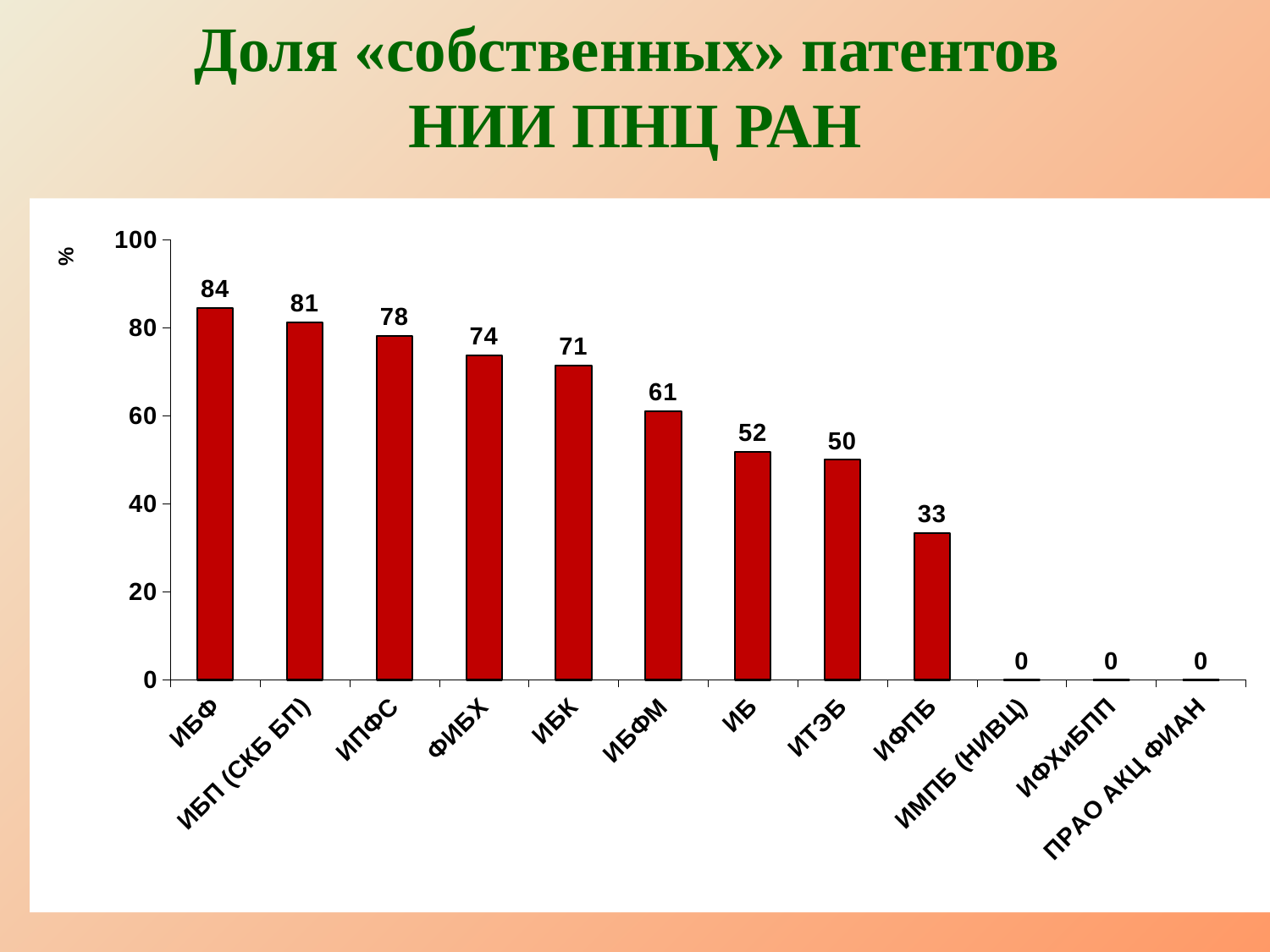
How many categories have a value of 0? 3 What is the value for ИФПБ? 33 Which category has the highest value? ИБФ What is the title of the slide? Доля «собственных» патентов НИИ ПНЦ РАН How many categories are shown on the x axis? 12 What is the difference between the values for ИПФС and ИБК? 7 Which is larger, the value for ФИБХ or the value for ИБ? ФИБХ Do the values rise or fall from left to right along the x axis? fall What is the value for ИБФМ? 61 What is the value for ИБФ? 84 What kind of chart is this? bar chart What is the difference between the values for ИБФ and ИТЭБ? 34